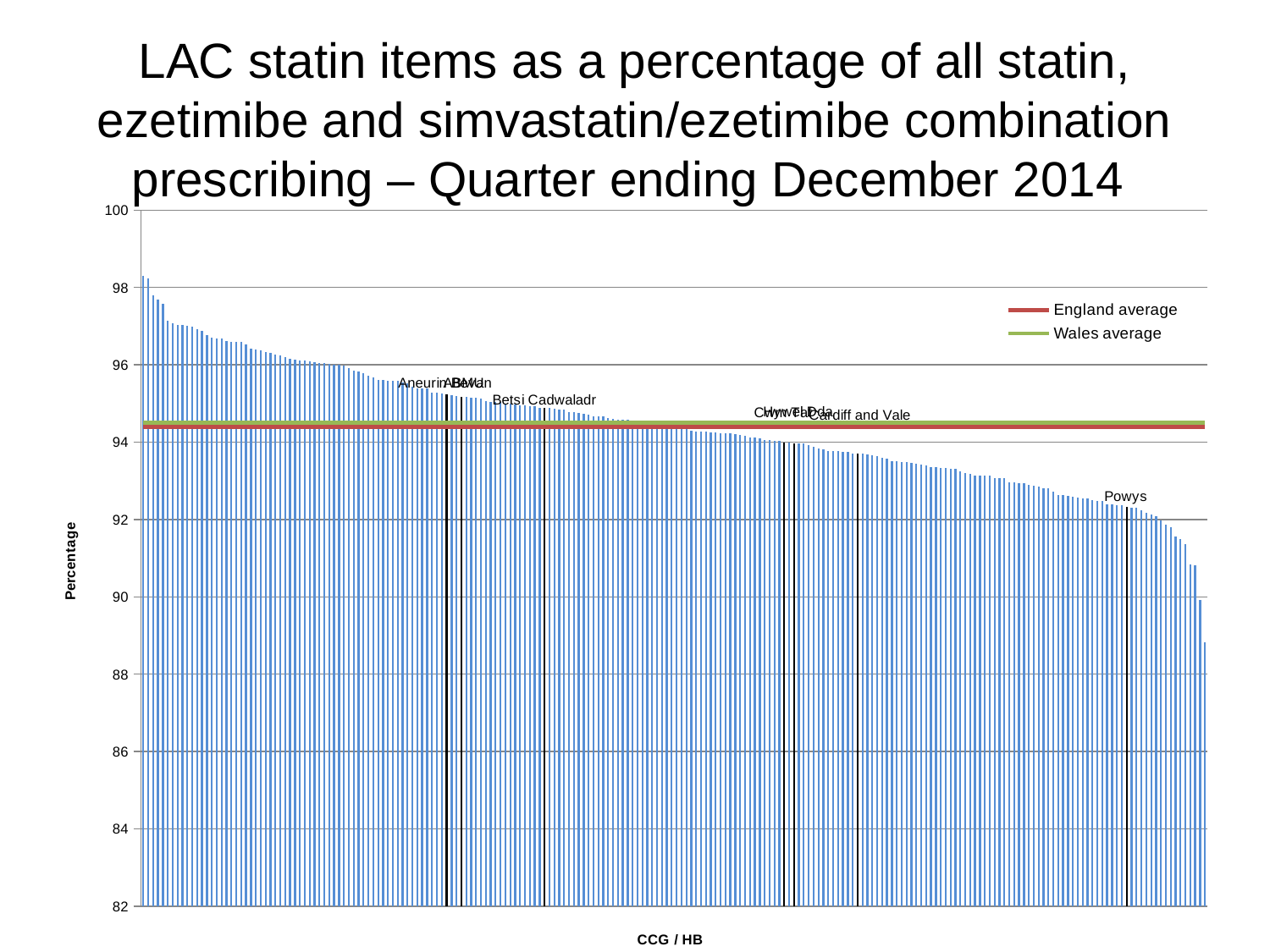
What is the label of the vertical axis? Percentage Is the value for Betsi Cadwaladr greater or less than 94? greater Which has the higher value, Betsi Cadwaladr or Powys? Betsi Cadwaladr Is the value for Betsi Cadwaladr greater or less than 96? less Which has the higher value, Aneurin Bevan or Cardiff and Vale? Aneurin Bevan Do the bar values rise or fall from left to right along the x axis? Fall Is the value for Powys greater or less than 94? less What kind of chart is shown on the slide? Bar chart How many entries does the chart legend list? 2 What are the two entries in the chart legend? England average and Wales average